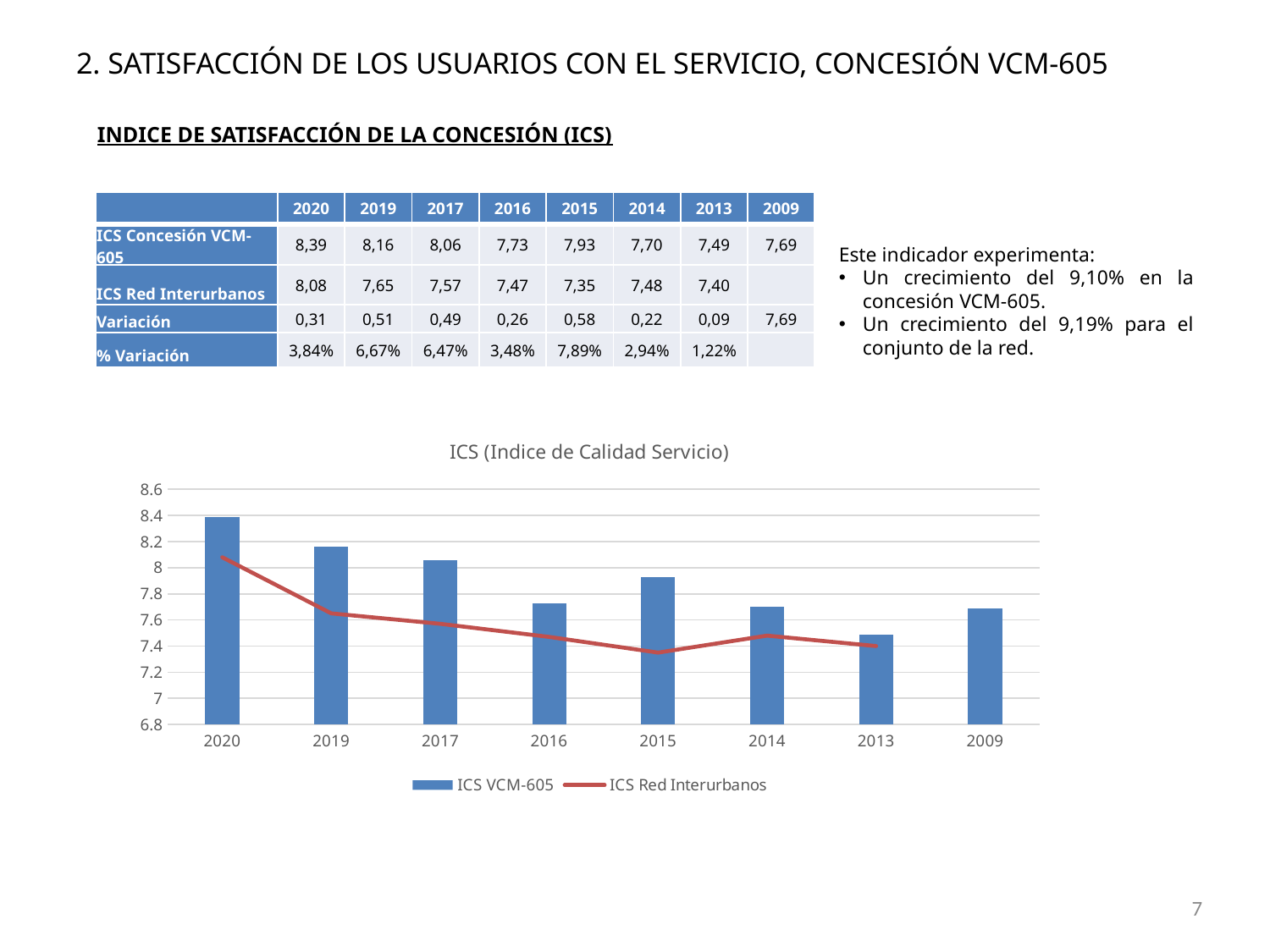
What is the ICS Red Interurbanos value for 2013, as printed in the table on the slide? 7,40 How many years are shown on the x axis of the ICS chart? 8 Is the ICS VCM-605 value for 2020 greater or less than 8.2? greater Using the values printed in the table, what is the difference between ICS VCM-605 and ICS Red Interurbanos in 2020? 0,31 What type of chart is shown under the title "ICS (Indice de Calidad Servicio)"? A combined bar and line chart Is the ICS Red Interurbanos value for 2015 greater or less than 7.4? less Which series is drawn as a red line in the ICS chart? ICS Red Interurbanos In the ICS chart, which is larger for 2019: ICS VCM-605 or ICS Red Interurbanos? ICS VCM-605 What is the ICS VCM-605 value for 2020, as printed in the table on the slide? 8,39 Which year has the highest ICS VCM-605 bar in the chart? 2020 How many series does the legend of the ICS chart list? 2 Which year has the lowest ICS VCM-605 bar in the chart? 2013